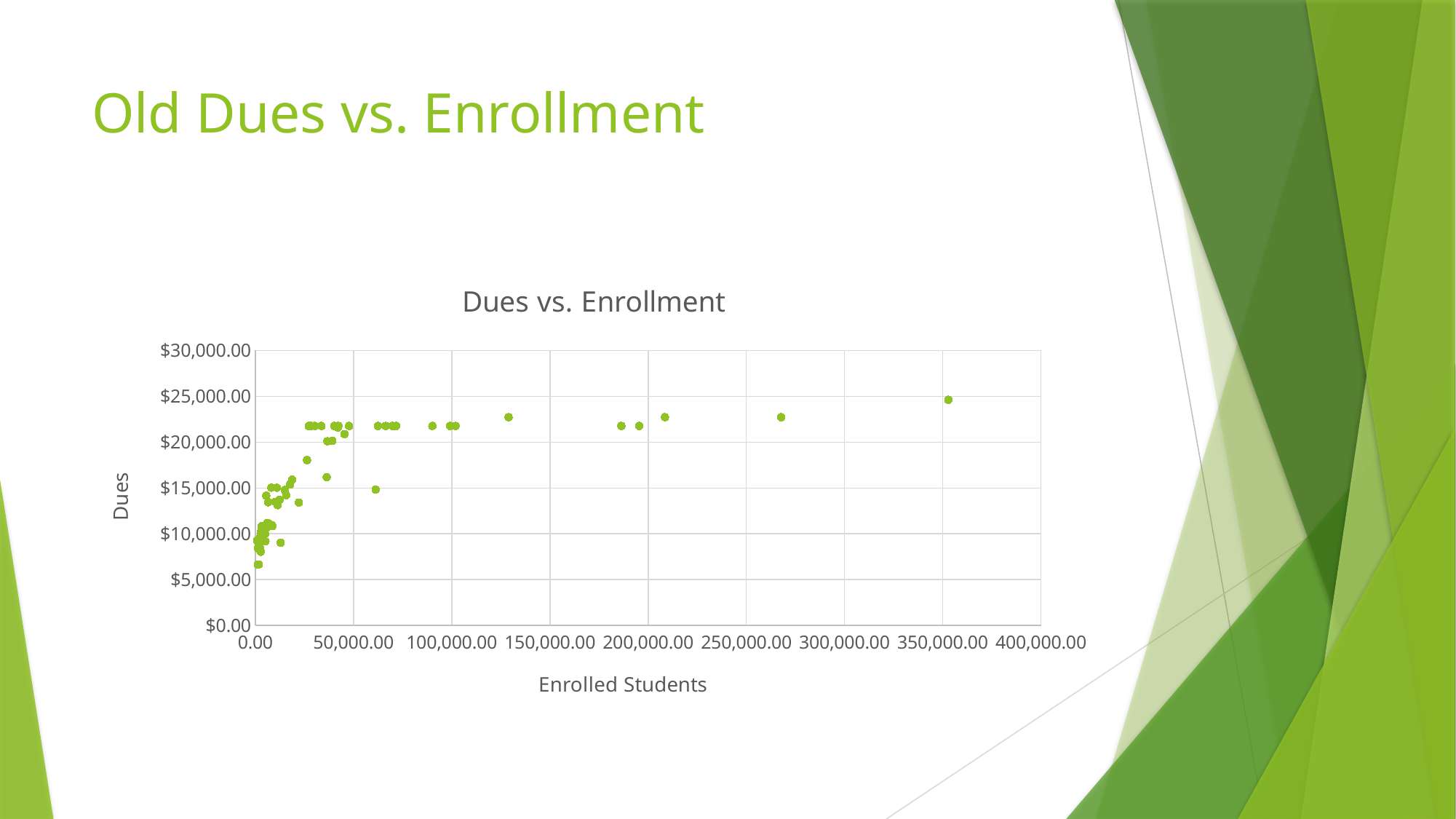
Is the dues value for the point at roughly 130,000 enrolled students greater or less than $20,000.00? greater What is the title of the chart? Dues vs. Enrollment What kind of chart is shown on the slide? scatter chart Is the dues value for the point with the highest enrollment (around 350,000 students) greater or less than $20,000.00? greater Do dues generally rise or fall as enrolled students increase along the x axis? rise What is the label of the vertical axis? Dues Is the dues value for the point at roughly 265,000 enrolled students greater or less than $25,000.00? less Which point has higher dues: the one at roughly 350,000 enrolled students or the one at roughly 60,000 enrolled students with dues near $15,000? the one at roughly 350,000 enrolled students What is the highest value shown on the vertical axis? $30,000.00